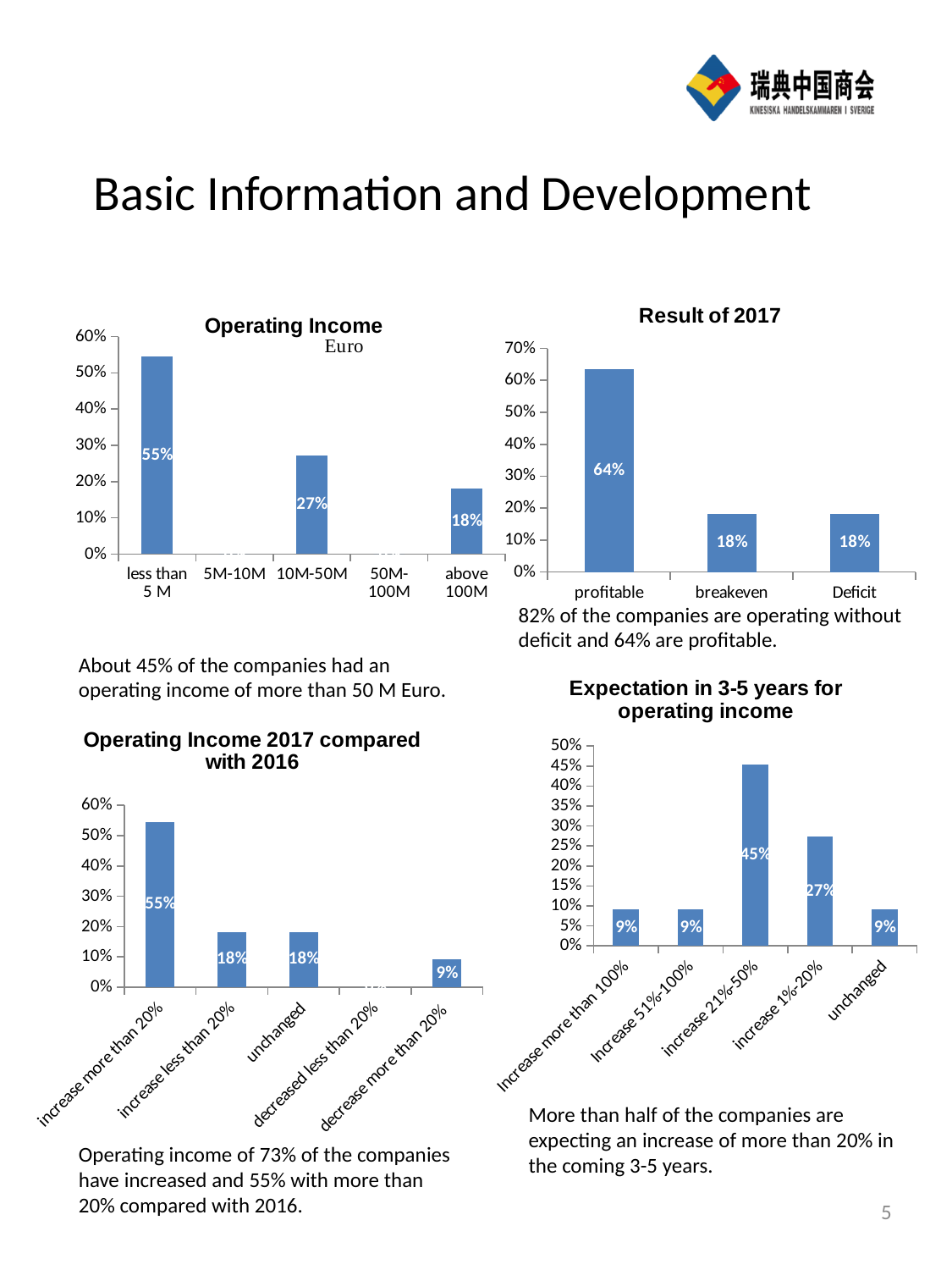
In the "Operating Income" chart, what is the value for "above 100M"? 18% What kind of chart is "Operating Income 2017 compared with 2016"? bar chart In the "Operating Income 2017 compared with 2016" chart, which is larger: "increase more than 20%" or "unchanged"? increase more than 20% In the "Operating Income" chart, what is the value for the "less than 5 M" category? 55% In the "Result of 2017" chart, which category has the highest value? profitable In the "Operating Income 2017 compared with 2016" chart, what is the value for "decrease more than 20%"? 9% In the "Result of 2017" chart, what is the difference between the values for "profitable" and "breakeven"? 46% In the "Operating Income" chart, how many categories are shown on the x axis? 5 In the "Expectation in 3-5 years for operating income" chart, what is the value for "increase 1%-20%"? 27% In the "Expectation in 3-5 years for operating income" chart, what is the difference between the values for "increase 21%-50%" and "increase 1%-20%"? 18% In the "Result of 2017" chart, what is the value for "Deficit"? 18% In the "Expectation in 3-5 years for operating income" chart, which category has the highest value? increase 21%-50%